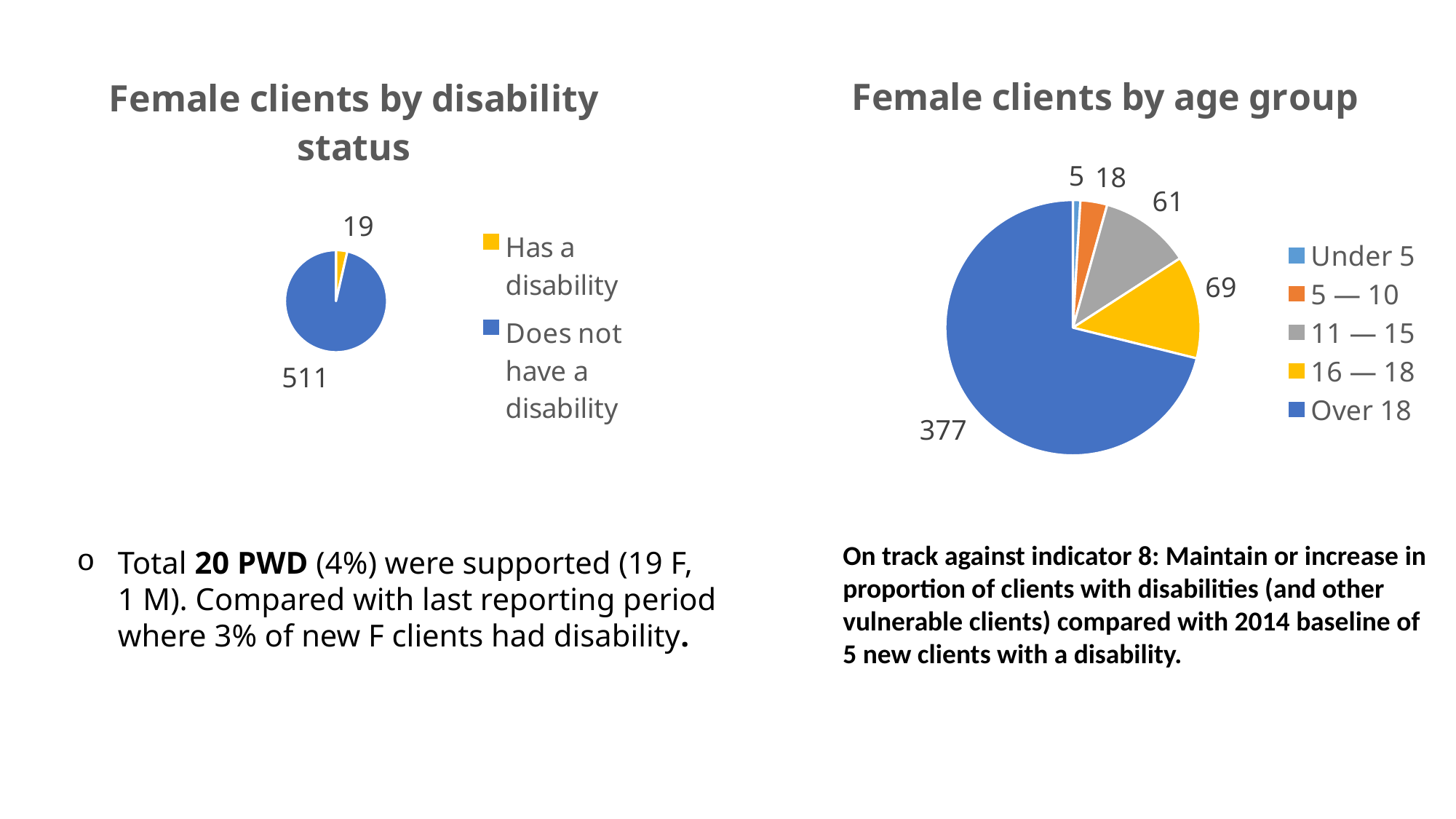
In the 'Female clients by age group' chart, which age group has the most clients? Over 18 In the 'Female clients by age group' chart, how many female clients are in the 11 — 15 age group? 61 In the 'Female clients by age group' chart, how many female clients are Over 18? 377 In the 'Female clients by age group' chart, how many age groups are shown? 5 In the 'Female clients by age group' chart, what is the difference between the Over 18 group and the 16 — 18 group? 308 In the 'Female clients by age group' chart, which age group has the fewest clients? Under 5 In the 'Female clients by age group' chart, what colour is the Over 18 slice? Blue In the 'Female clients by age group' chart, which is larger: the 5 — 10 group or the 16 — 18 group? 16 — 18 In the 'Female clients by disability status' chart, what is the difference between the number of clients without a disability and the number with a disability? 492 In the 'Female clients by disability status' chart, how many female clients do not have a disability? 511 What kind of chart is 'Female clients by disability status'? Pie chart In the 'Female clients by disability status' chart, how many female clients have a disability? 19